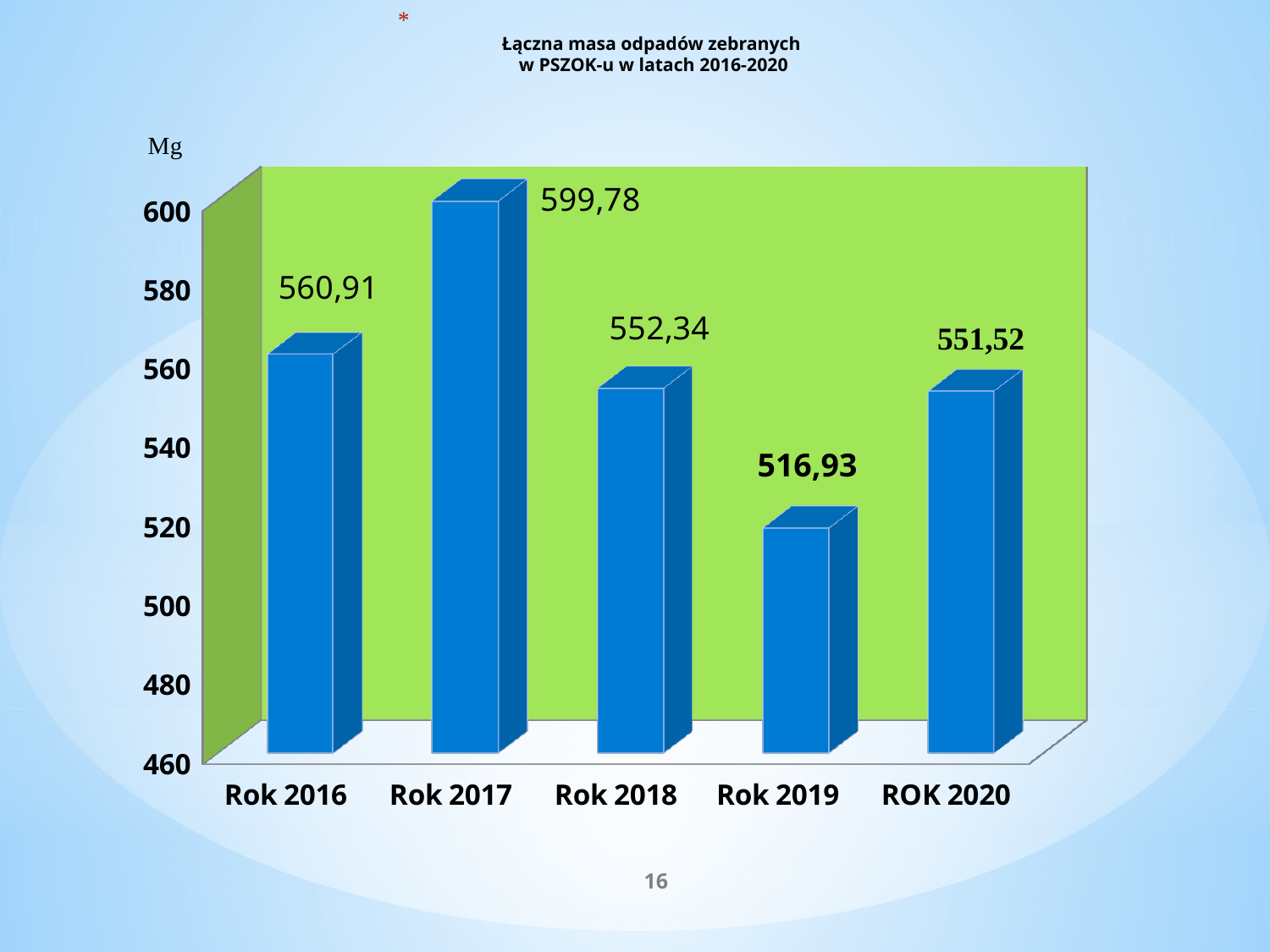
What is the difference between the values for Rok 2017 and Rok 2016? 38,87 Which is larger, the value for Rok 2016 or the value for Rok 2018? Rok 2016 Which year has the highest value? Rok 2017 How many years are shown on the x axis? 5 What kind of chart is shown on the slide? bar chart Do the values rise or fall from Rok 2017 to Rok 2019? fall Is the value for Rok 2019 greater or less than 520? less What is the value for Rok 2019? 516,93 What is the value for Rok 2016? 560,91 What is the value for ROK 2020? 551,52 What is the difference between the values for Rok 2018 and ROK 2020? 0,82 Which year has the lowest value? Rok 2019